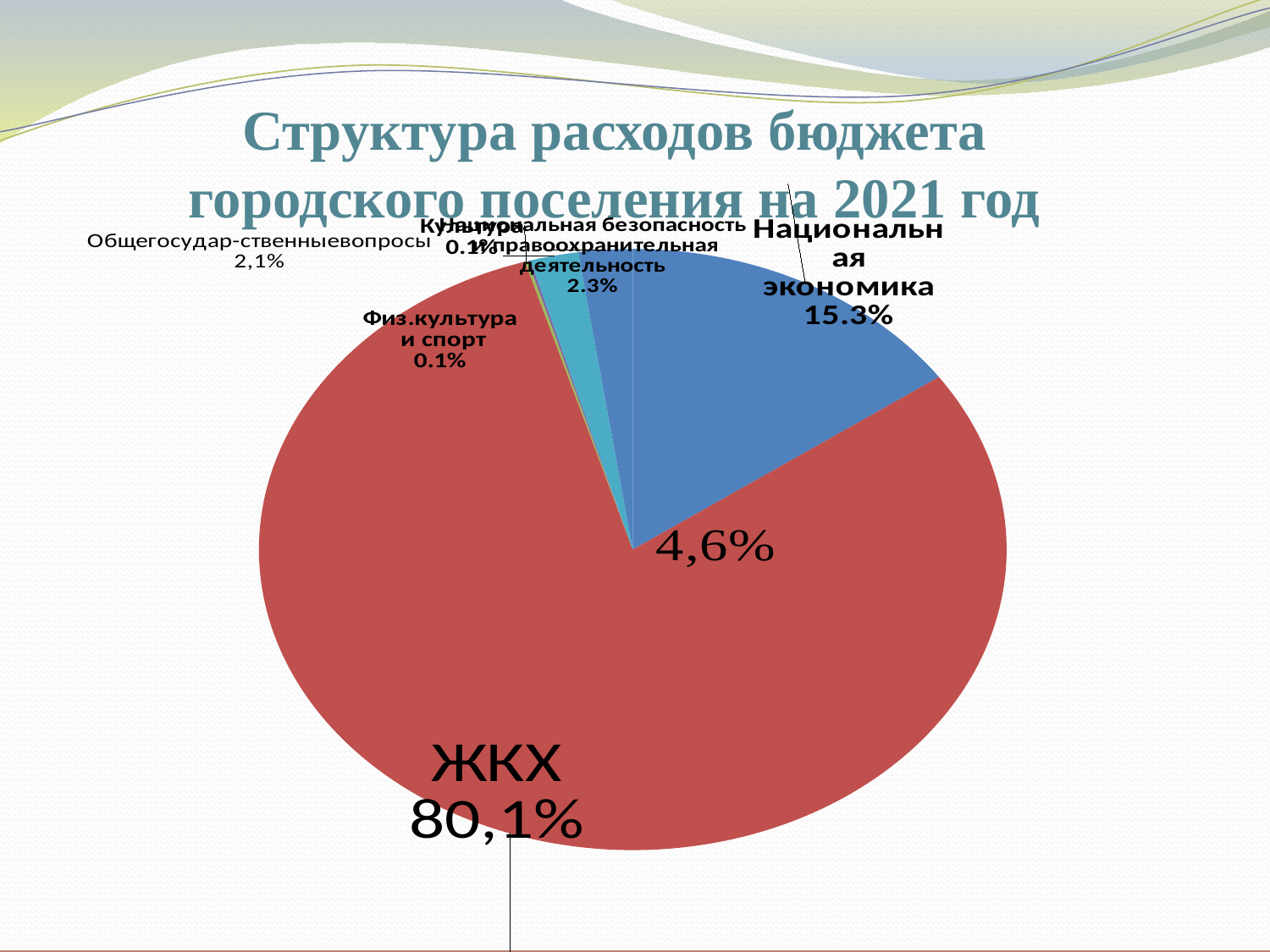
Which category has the largest share of the pie? ЖКХ What is the title of the chart? Структура расходов бюджета городского поселения на 2021 год What share is shown for Национальная экономика? 15.3% What share is shown for Культура? 0.1% What kind of chart is shown on the slide? pie chart Which is larger: the share for Национальная экономика or the share for Общегосударственные вопросы? Национальная экономика What share is shown for Физ.культура и спорт? 0.1% What share is shown for Национальная безопасность и правоохранительная деятельность? 2.3% What colour is the ЖКХ slice? red What share is shown for Общегосударственные вопросы? 2,1% By how many percentage points does Национальная экономика exceed Национальная безопасность и правоохранительная деятельность? 13.0 percentage points What share of the budget expenditure does ЖКХ account for? 80,1%